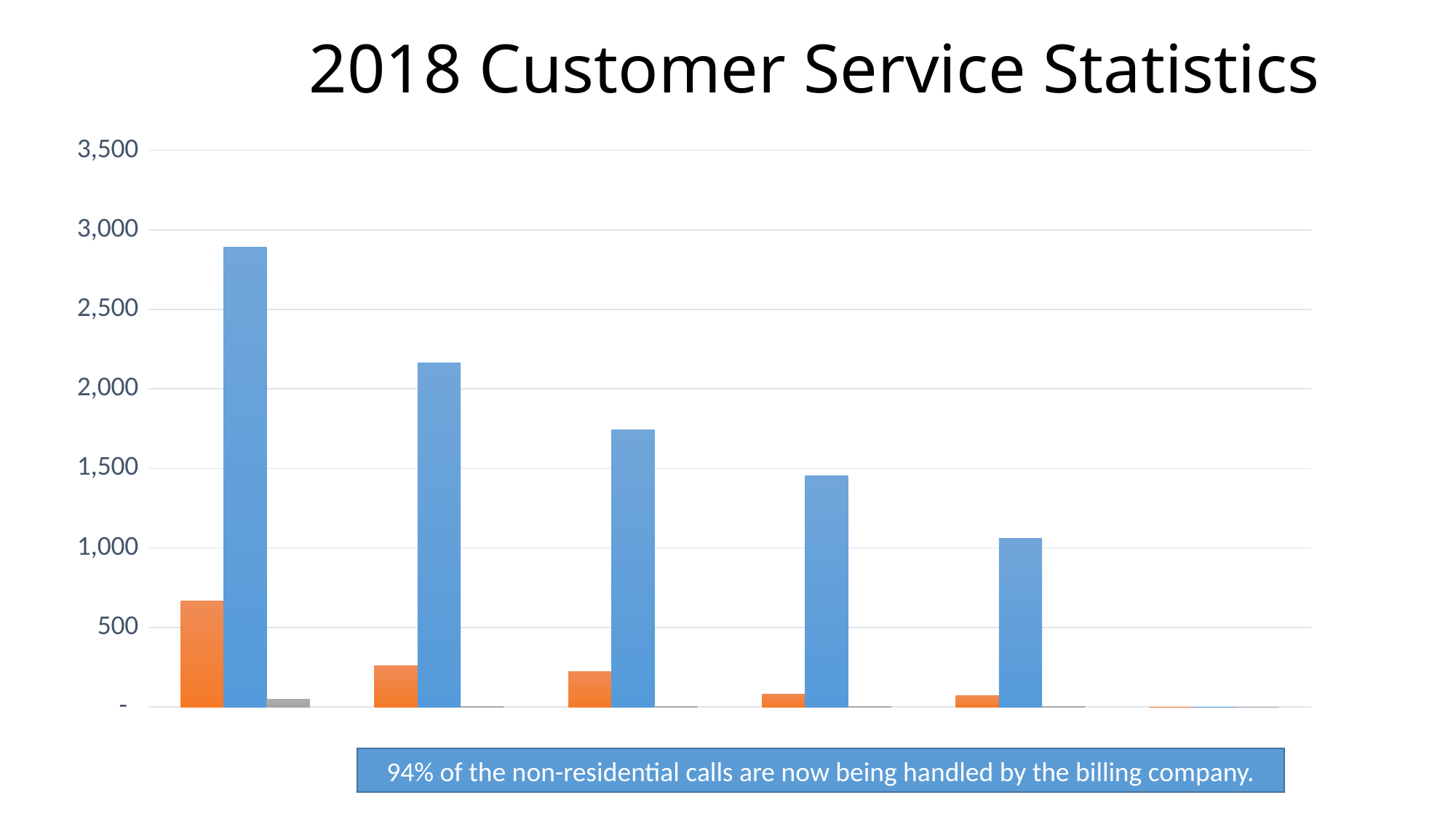
Is the value of the orange bar in the second group from the left greater or less than 500? less Is the value of the blue bar in the first (leftmost) group greater or less than 2,500? greater Is the value of the orange bar in the first (leftmost) group greater or less than 500? greater According to the text box below the chart, what percentage of non-residential calls are now handled by the billing company? 94% Which bar is the tallest on the chart? the blue bar in the first (leftmost) group Which is larger: the blue bar in the first group or the blue bar in the second group? the blue bar in the first group What kind of chart is shown on the slide? bar chart Do the blue bars rise or fall from left to right across the chart? fall What is the title of the chart on the slide? 2018 Customer Service Statistics